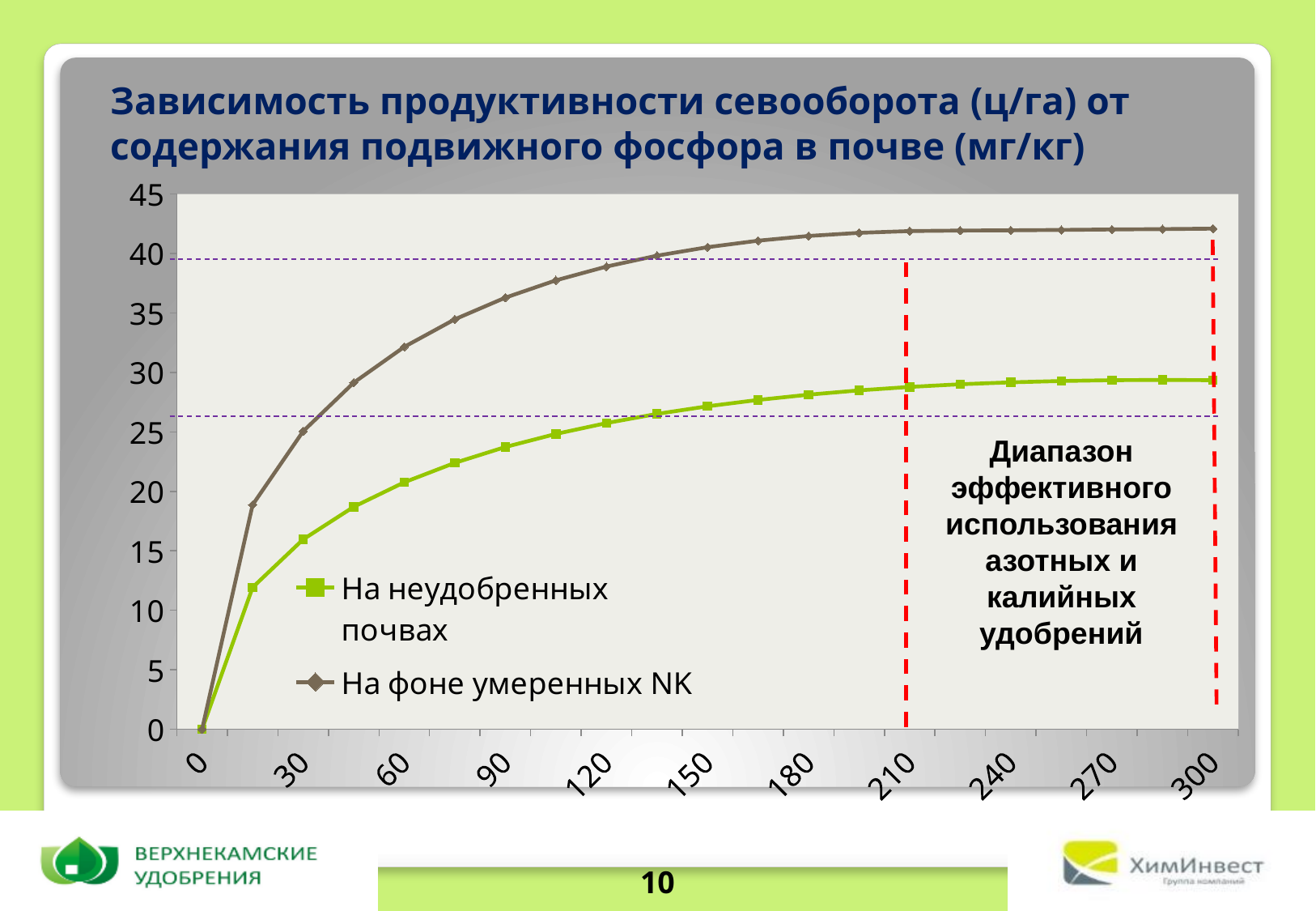
Is the value for "На неудобренных почвах" at 30 greater or less than 20? less Is the value for "На фоне умеренных NK" at 30 greater or less than 20? greater Which series is drawn in green with square markers? На неудобренных почвах What are the two series named in the legend? На неудобренных почвах; На фоне умеренных NK Is the value for "На фоне умеренных NK" at 300 greater or less than 40? greater At 150 on the x axis, which series has the higher value? На фоне умеренных NK How many series does the legend list? 2 What is the value of the series "На фоне умеренных NK" at 0 on the x axis? 0 What kind of chart is shown on the slide? line chart Do the values of the series "На неудобренных почвах" rise or fall as the x-axis value increases? rise